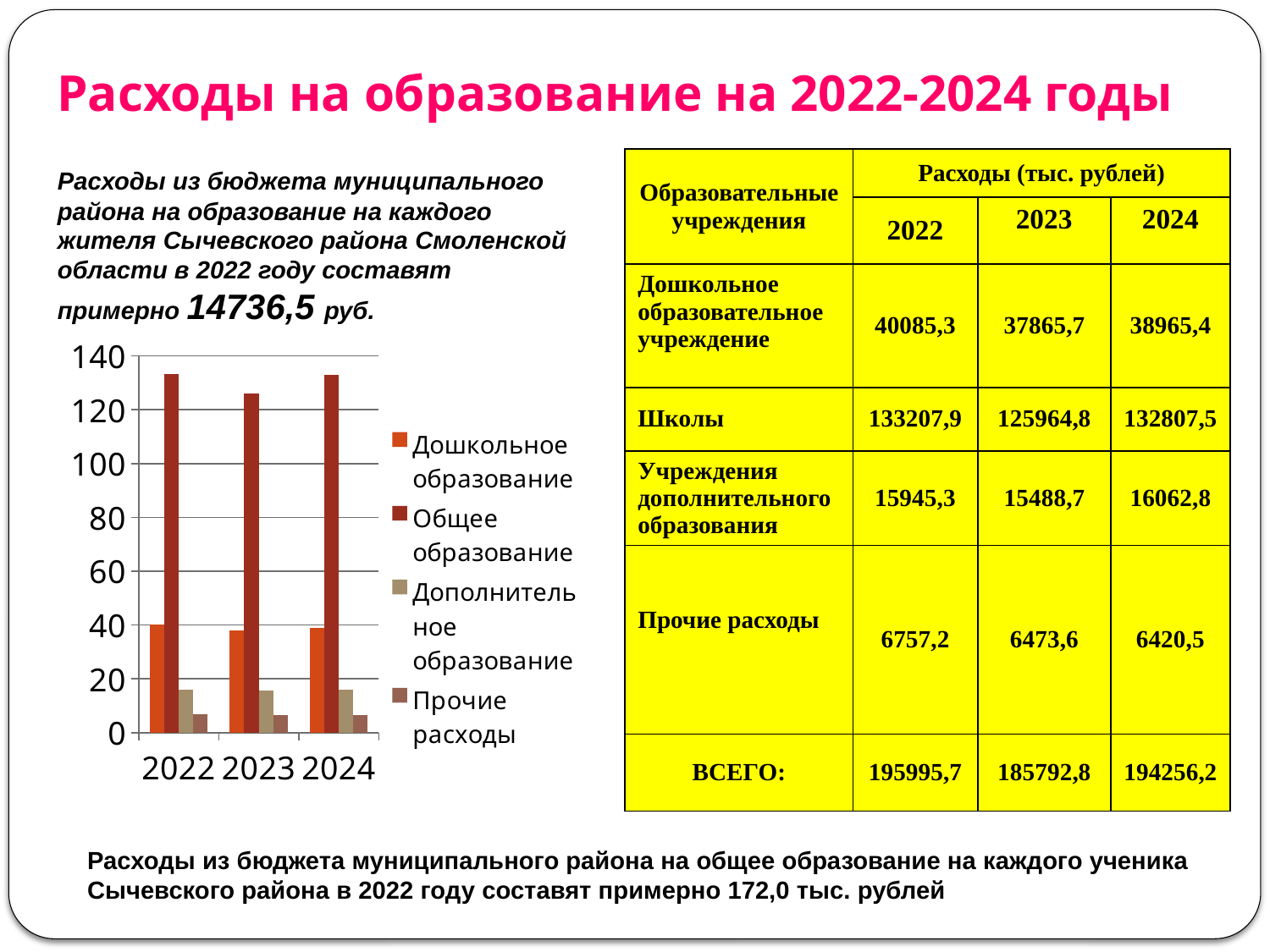
How many series does the chart legend list? 4 Which series has the tallest bar in 2022? Общее образование What is the highest value shown on the chart's vertical axis? 140 Is the value for Прочие расходы in 2022 greater or less than 20? less How many years are shown on the x axis of the chart? 3 Is the value for Дополнительное образование in 2024 greater or less than 20? less Which is larger in 2023: Дошкольное образование or Дополнительное образование? Дошкольное образование Which series has the shortest bar in 2024? Прочие расходы Is the value for Дошкольное образование in 2023 greater or less than 60? less What kind of chart is shown on the slide? bar chart Which is larger: Общее образование in 2022 or Общее образование in 2023? 2022